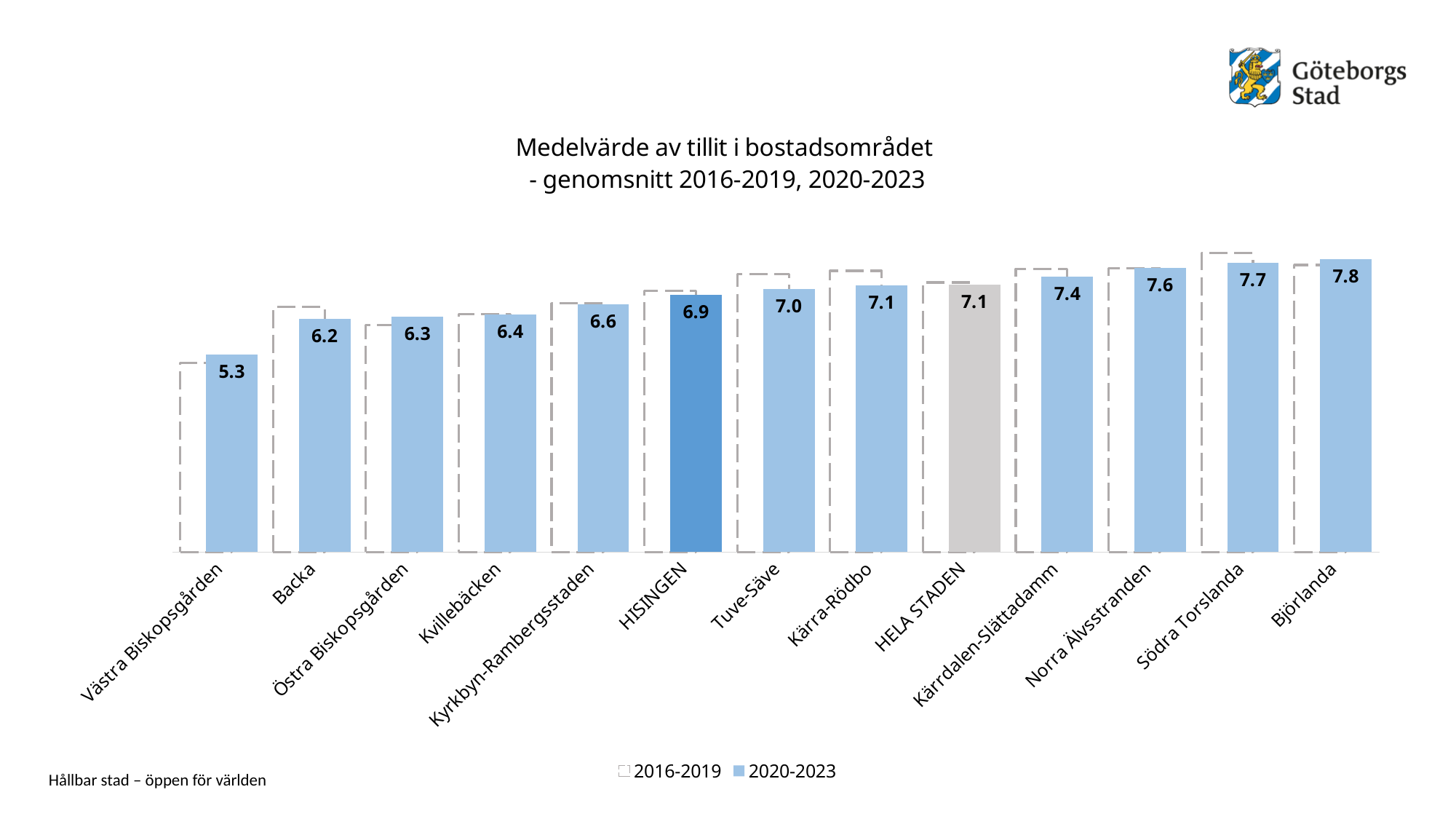
Do the 2020-2023 values rise or fall from left to right along the x axis? Rise Which has a larger 2020-2023 value, Kvillebäcken or Norra Älvsstranden? Norra Älvsstranden What is the 2020-2023 value for Backa? 6.2 How many series does the legend list? 2 Which category has the lowest 2020-2023 value? Västra Biskopsgården Which category has the highest 2020-2023 value? Björlanda What is the 2020-2023 value for HELA STADEN? 7.1 What kind of chart is shown on the slide? Bar chart What is the difference between the 2020-2023 values for Björlanda and Västra Biskopsgården? 2.5 What is the 2020-2023 value for HISINGEN? 6.9 What is the 2020-2023 value for Kärrdalen-Slättadamm? 7.4 How many categories are shown on the x axis? 13